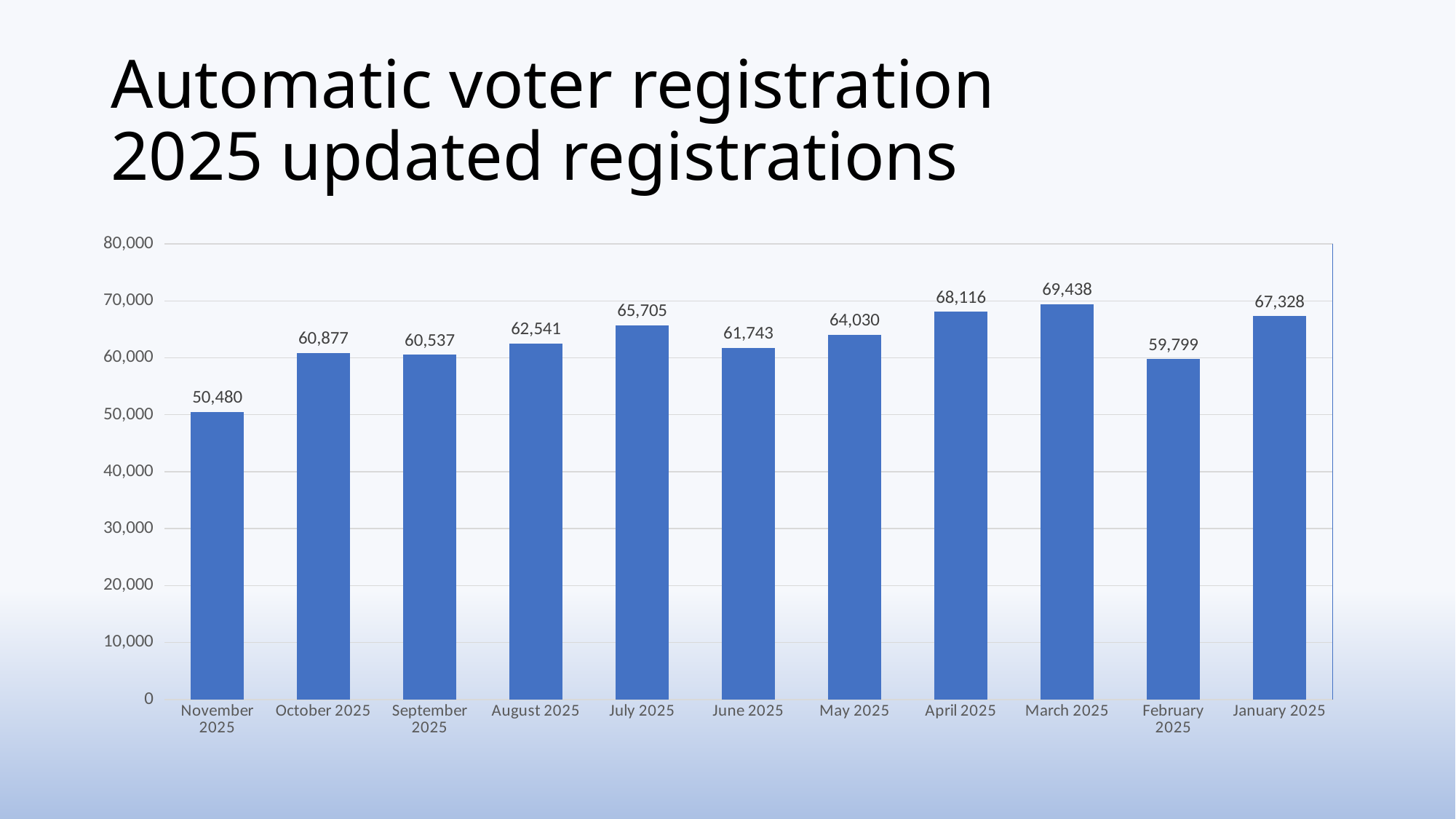
What is the difference between the values for March 2025 and November 2025? 18,958 What is the value for November 2025? 50,480 Which month has the lowest value? November 2025 Which is larger, the value for January 2025 or the value for February 2025? January 2025 What is the difference between the values for April 2025 and May 2025? 4,086 Is the value for February 2025 greater or less than 60,000? less How many months are shown on the chart? 11 Which month has the highest value? March 2025 What is the value for July 2025? 65,705 What kind of chart is shown on the slide? bar chart What is the title of the slide? Automatic voter registration 2025 updated registrations What is the value for March 2025? 69,438